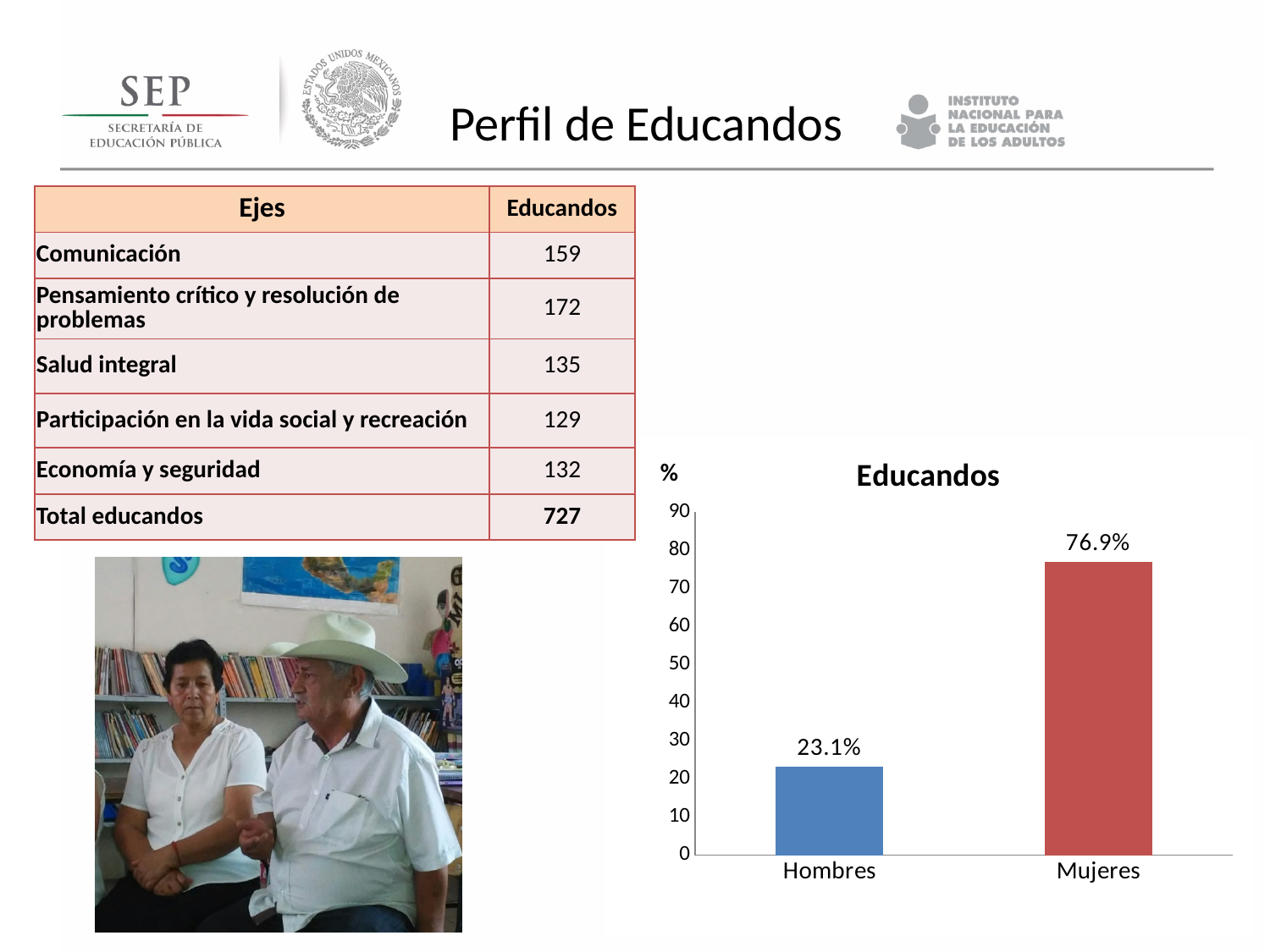
How many categories are shown in the Educandos chart? 2 Is the value for Hombres in the Educandos chart greater or less than 30? less Is the value for Mujeres in the Educandos chart greater or less than 70? greater Which is larger in the Educandos chart, the value for Hombres or the value for Mujeres? Mujeres What is the value for Mujeres in the Educandos chart? 76.9% What colour is the bar for Mujeres in the Educandos chart? red What is the difference between the values for Mujeres and Hombres in the Educandos chart? 53.8% What kind of chart is the Educandos chart? bar chart Which category has the highest value in the Educandos chart? Mujeres Which category has the lowest value in the Educandos chart? Hombres What is the title of the chart on the slide? Educandos What is the value for Hombres in the Educandos chart? 23.1%